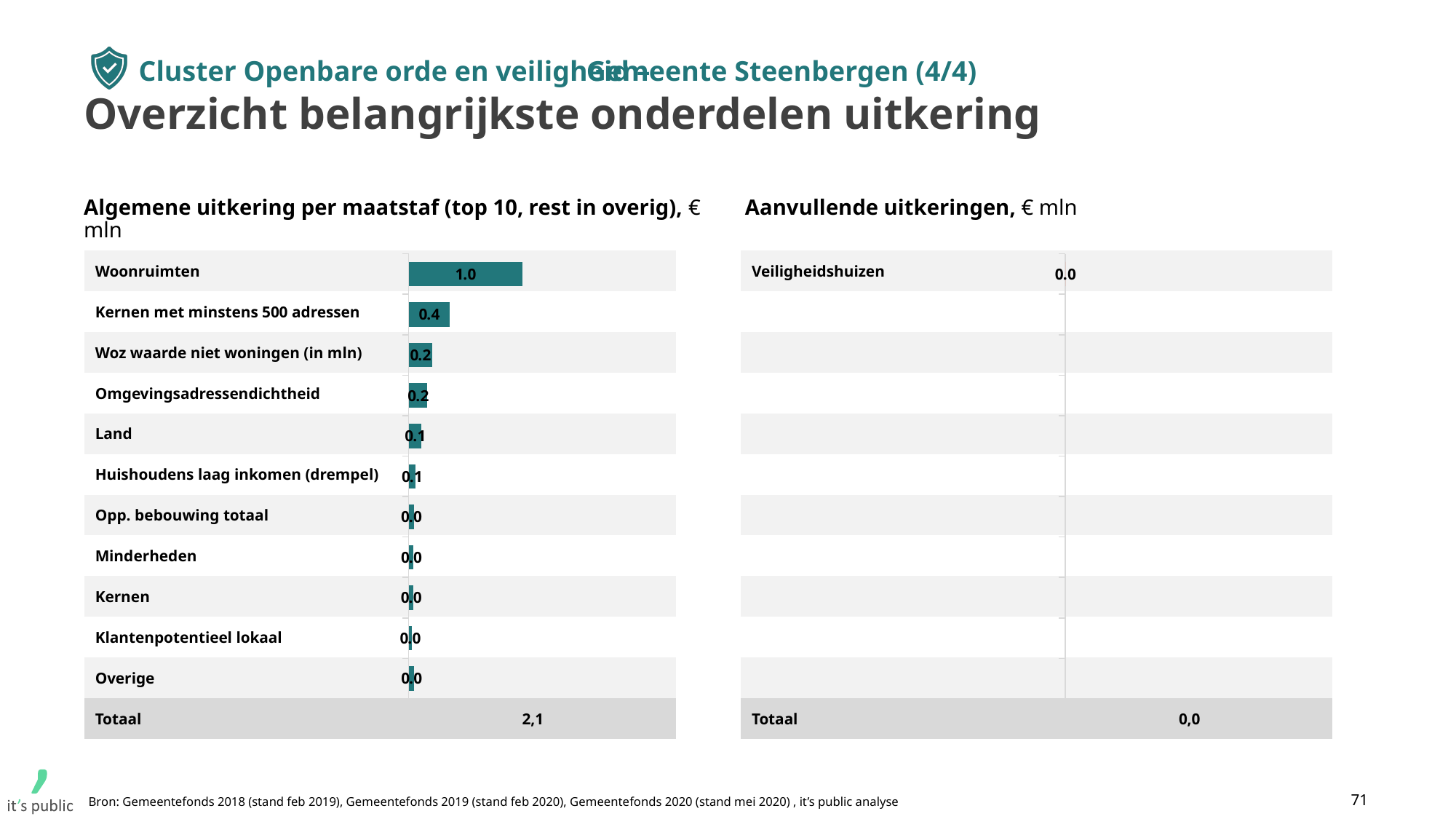
What kind of chart is the left chart 'Algemene uitkering per maatstaf'? Bar chart In the left chart 'Algemene uitkering per maatstaf', what is the difference between Woonruimten and Kernen met minstens 500 adressen? 0.6 In the left chart 'Algemene uitkering per maatstaf', what is the value for Woonruimten? 1.0 In the left chart 'Algemene uitkering per maatstaf', what is the value for Kernen met minstens 500 adressen? 0.4 In the left chart 'Algemene uitkering per maatstaf', what is the value for Land? 0.1 In the left chart 'Algemene uitkering per maatstaf', which category has the highest value? Woonruimten In the left chart 'Algemene uitkering per maatstaf', which is larger: Woz waarde niet woningen (in mln) or Land? Woz waarde niet woningen (in mln) In the left chart 'Algemene uitkering per maatstaf', how many categories are shown (excluding the Totaal row)? 11 In the right chart 'Aanvullende uitkeringen', what is the Totaal value shown? 0,0 What unit is stated in the title of the right chart 'Aanvullende uitkeringen'? € mln In the left chart 'Algemene uitkering per maatstaf', what is the Totaal value shown? 2,1 In the right chart 'Aanvullende uitkeringen', what is the value for Veiligheidshuizen? 0.0